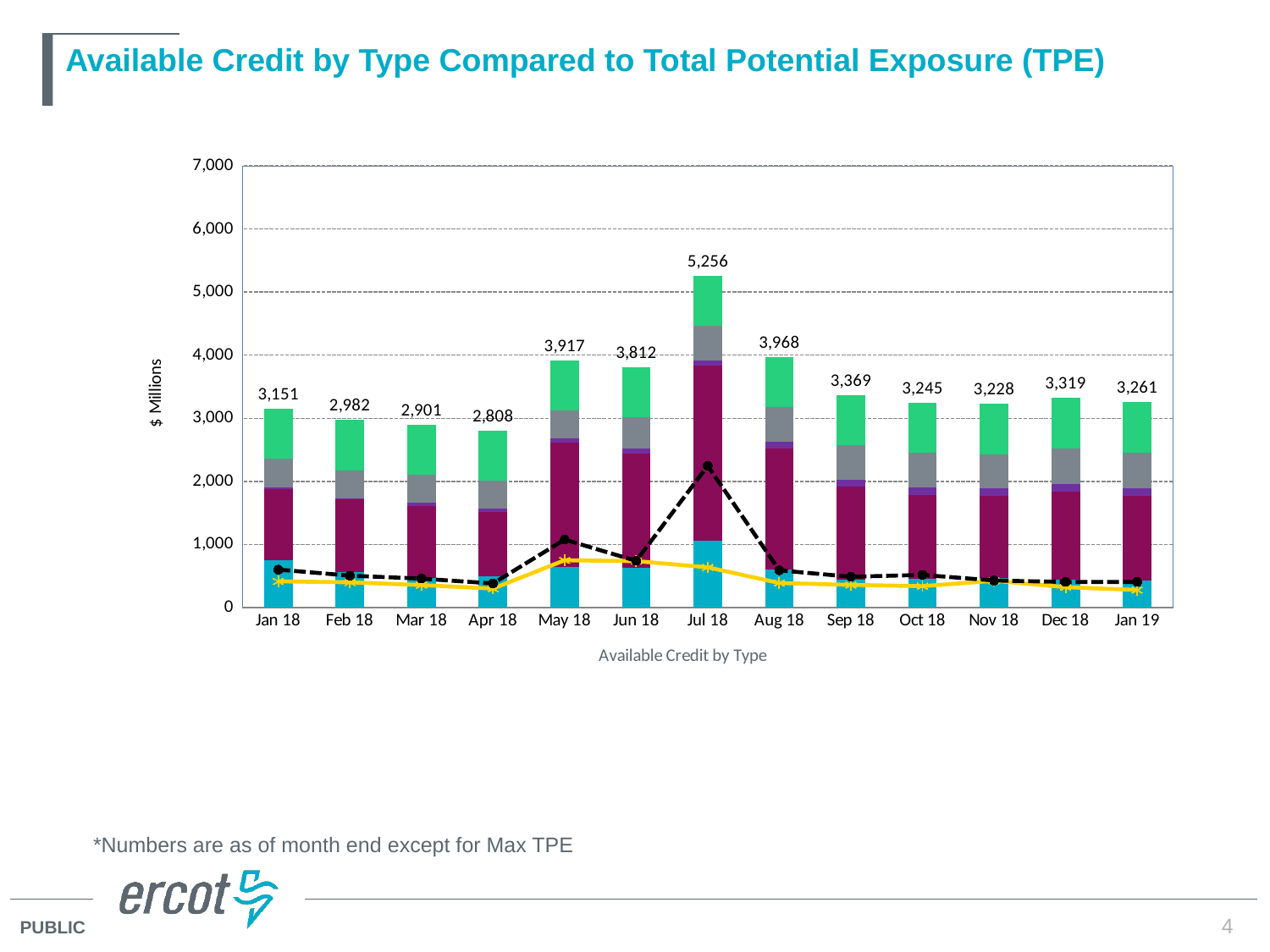
What is the total available credit shown for Jul 18? 5,256 What is the total available credit shown for Jan 19? 3,261 What is the difference between the total available credit in Jul 18 and Aug 18? 1,288 Do the total available credit values rise or fall from Jan 18 to Apr 18? Fall Is the value of the dashed black line in Jul 18 greater or less than 2,000? greater Which month has the lowest total available credit? Apr 18 What kind of chart is used to show available credit by type? Stacked bar chart with line overlays How many months are shown on the x axis? 13 Which month has the highest total available credit? Jul 18 What is the total available credit shown for Apr 18? 2,808 What is the label on the vertical axis of the chart? $ Millions Which month has a larger total available credit, May 18 or Jun 18? May 18